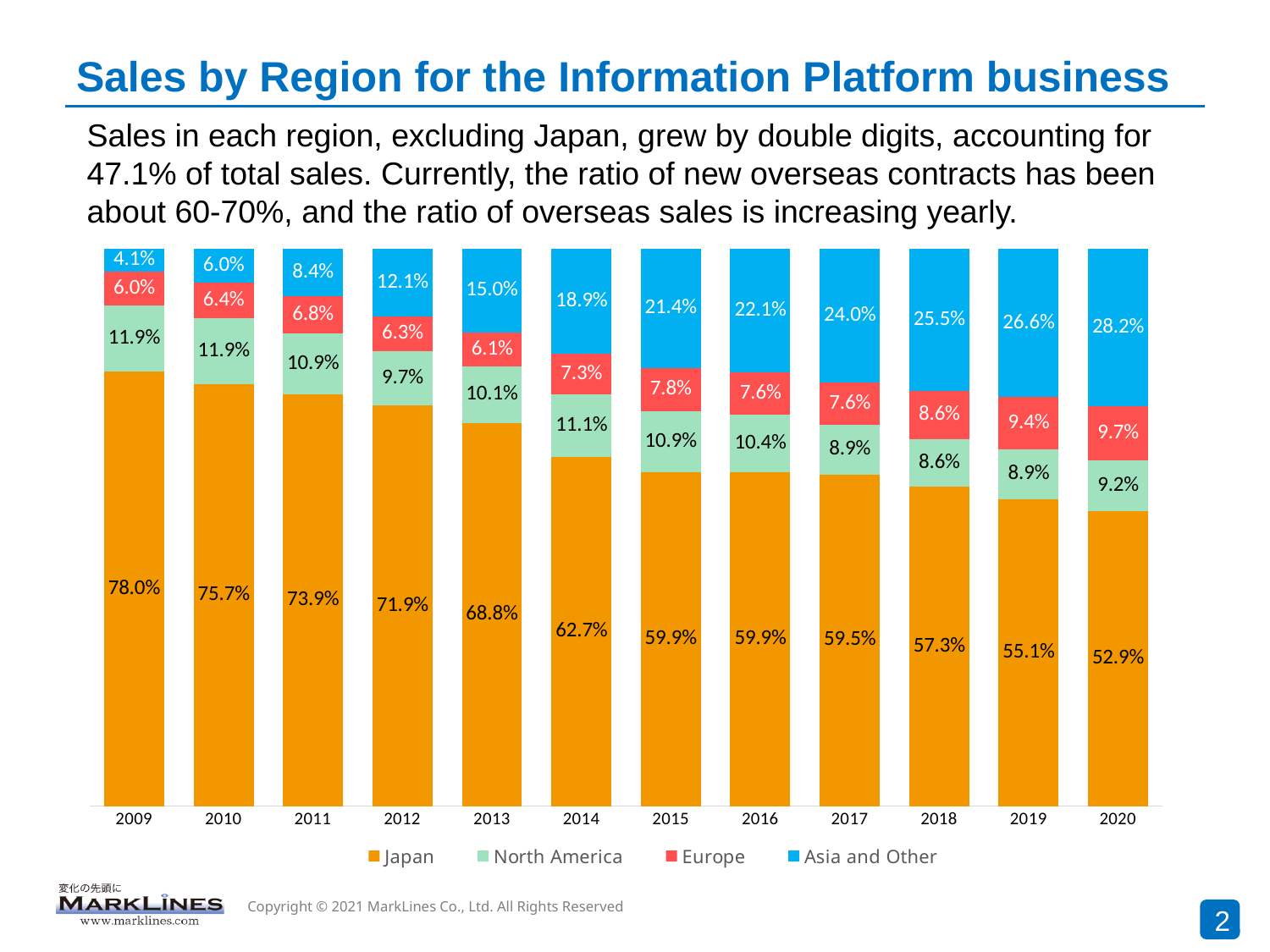
Does the Asia and Other share rise or fall from 2009 to 2020? Rise What is the value for North America in 2012? 9.7% By how many percentage points did the Japan share fall from 2009 to 2020? 25.1 percentage points How many series does the legend list? 4 What is the value for Japan in 2020? 52.9% What kind of chart is shown on the slide? Stacked bar chart In which year is the Asia and Other share lowest? 2009 In 2016, which is larger: North America or Europe? North America What is the value for Europe in 2019? 9.4% What is the value for Asia and Other in 2014? 18.9% How many years are shown on the x axis? 12 In which year is the Japan share highest? 2009